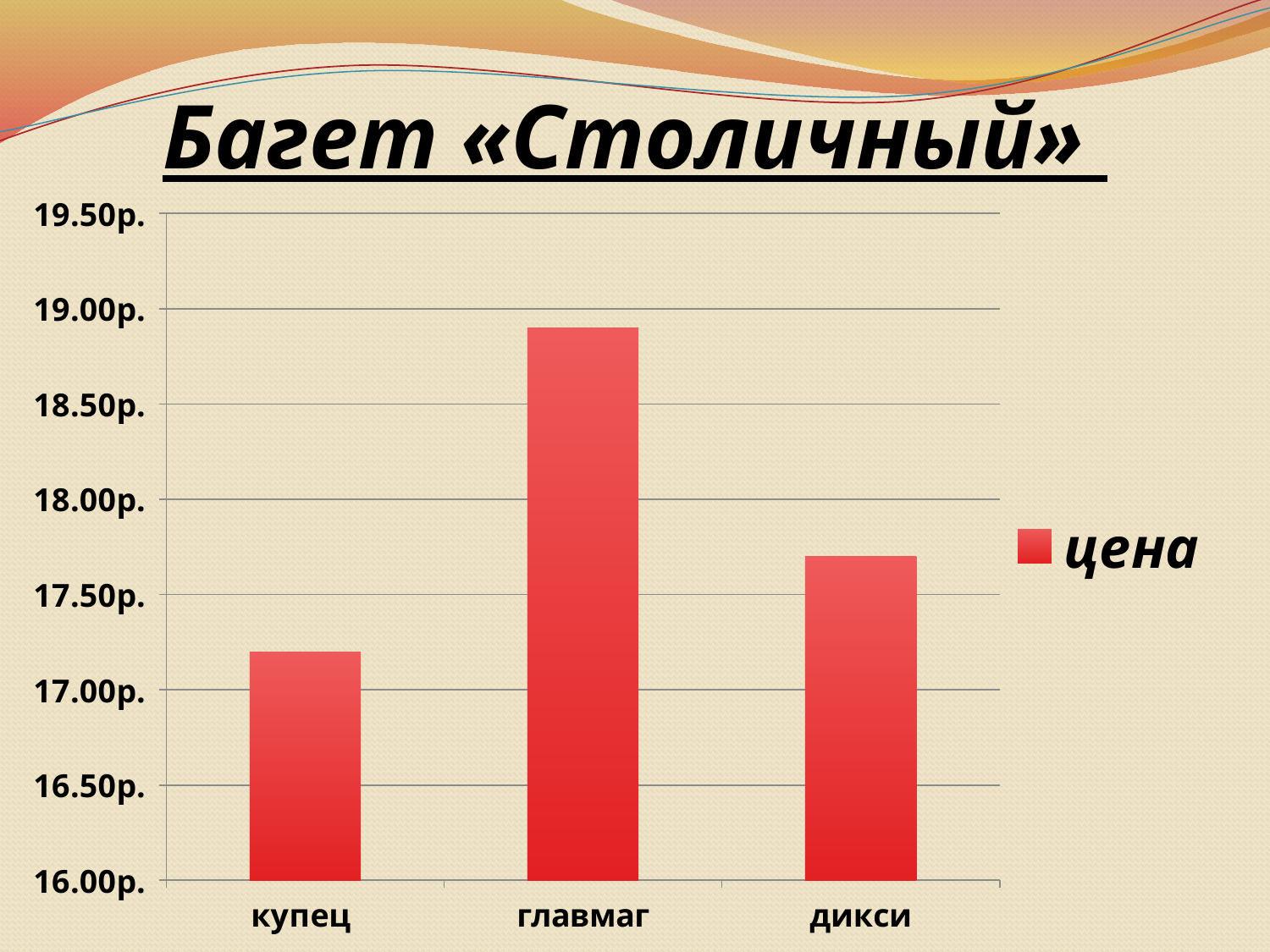
Is the price at купец greater or less than 17.00р.? greater What is the name of the series shown in the legend? цена What kind of chart is shown on the slide? bar chart Is the price at дикси greater or less than 17.50р.? greater Is the price at купец greater or less than 17.50р.? less How many series does the legend list? 1 How many stores are shown on the x axis of the chart? 3 Which store has the highest price for Багет «Столичный»? главмаг Which store has the lowest price for Багет «Столичный»? купец Which store has a higher price, дикси or купец? дикси